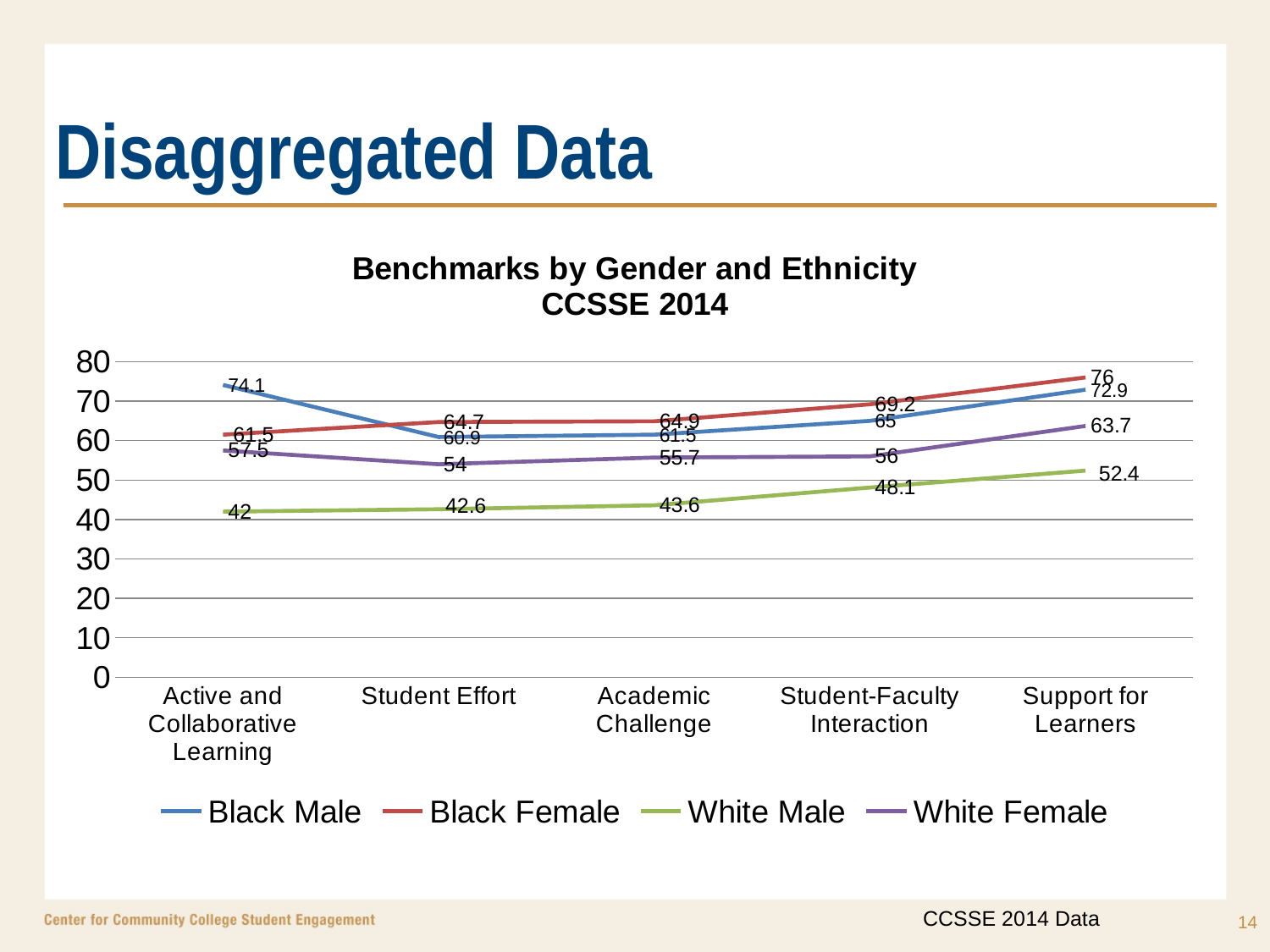
What kind of chart is shown on the slide? Line chart What is the Black Male value for Active and Collaborative Learning? 74.1 What is the White Male value for Support for Learners? 52.4 How many series does the legend list? 4 What is the Black Female value for Support for Learners? 76 How many benchmark categories are shown on the x axis? 5 Which benchmark has the lowest Black Male value? Student Effort What is the White Female value for Student-Faculty Interaction? 56 For Active and Collaborative Learning, which is larger: the Black Male value or the Black Female value? Black Male What is the difference between the Black Female and White Male values for Support for Learners? 23.6 Which benchmark has the highest White Male value? Support for Learners Does the White Male line rise or fall from Active and Collaborative Learning to Support for Learners? Rise